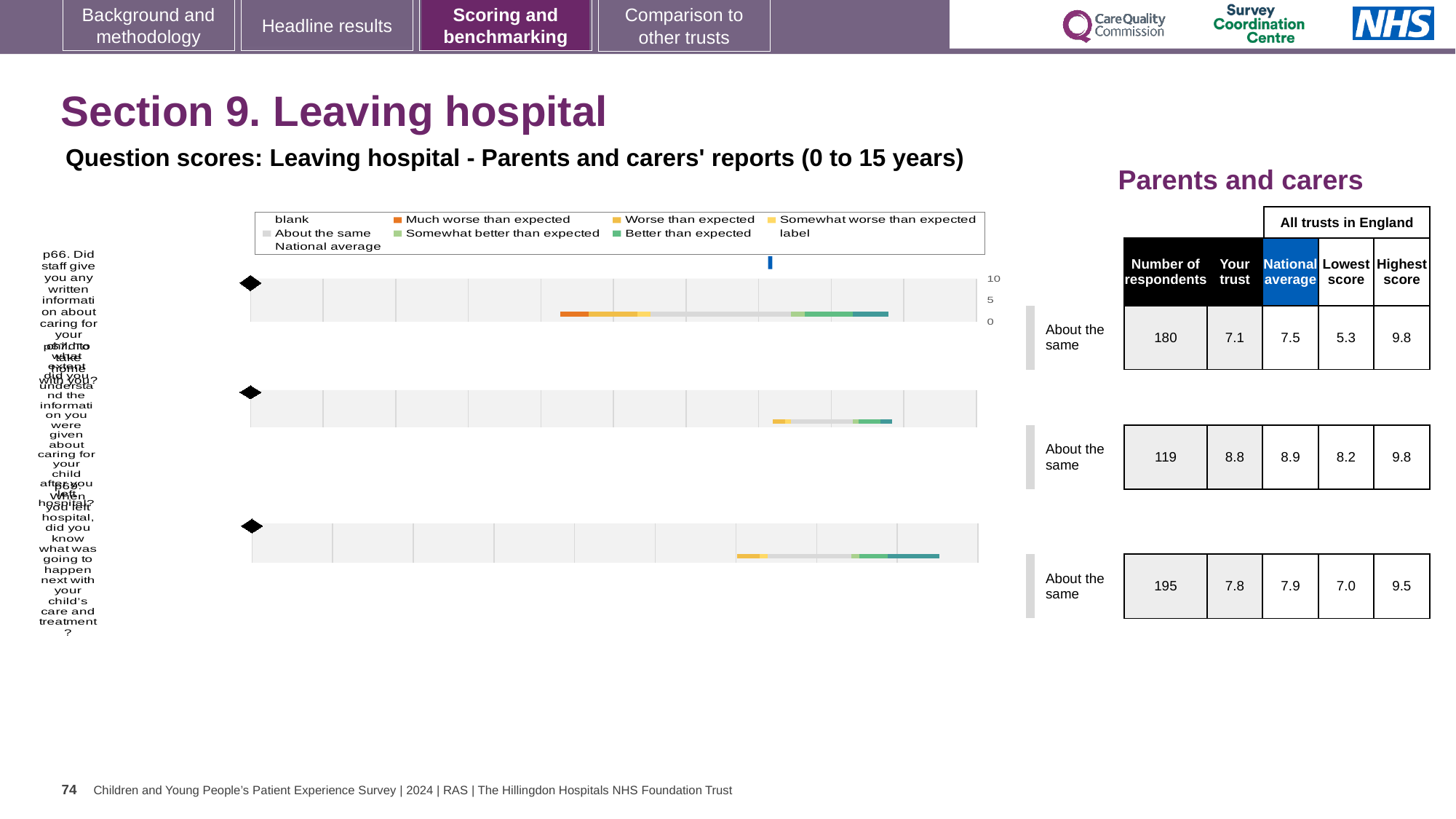
What is the highest value shown on the chart axis? 10 In the table, what is the difference between the highest score and the lowest score for the third question row? 2.5 In the table, what is the national average for the third question row? 7.9 Which question row has the highest 'Your trust' score in the table? the second row (8.8) In the table, what is the 'Your trust' score for the second question row? 8.8 What benchmark category is shown next to all three question rows? About the same In the first question row of the table, is the 'Your trust' score higher or lower than the national average? lower In the chart legend, what colour represents 'Much worse than expected'? orange What kind of chart is used to show the question scores on this slide? bar chart In the table, what is the highest score for the first question row? 9.8 How many question bar charts are shown on the slide? 3 In the table, what is the number of respondents for the first question row? 180